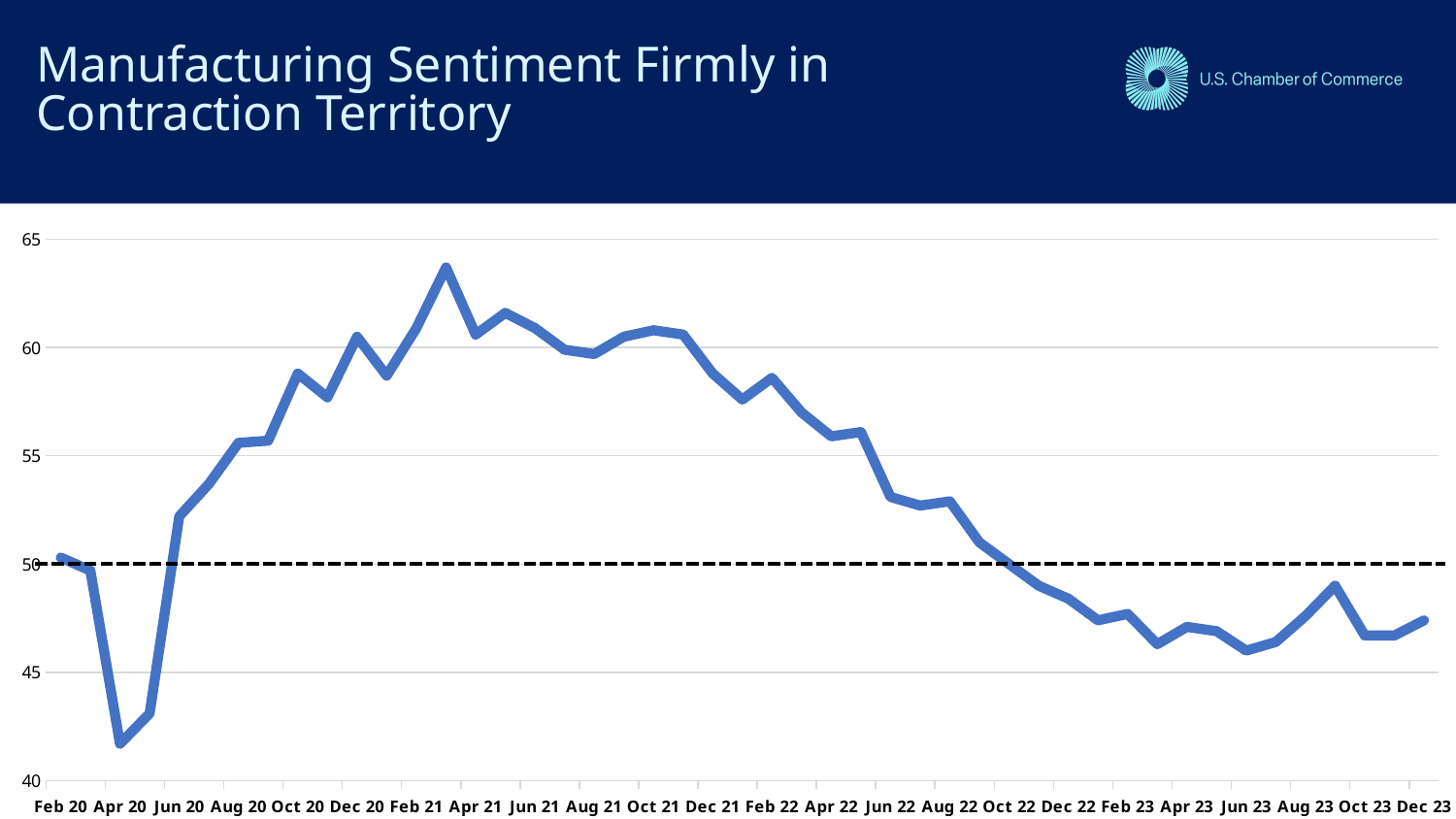
Is the value for Oct 20 greater or less than 55? greater Which labeled month has the lowest value on the chart? Apr 20 Is the value for Dec 23 greater or less than 50? less What kind of chart is shown on the slide? line chart Is the value for Jun 21 greater or less than 60? greater At what value is the horizontal dashed reference line drawn? 50 What is the title of the slide's chart? Manufacturing Sentiment Firmly in Contraction Territory How many month labels are shown on the x axis? 24 Does the line generally rise or fall between Apr 20 and Feb 21? rise Does the line generally rise or fall between Oct 21 and Dec 22? fall